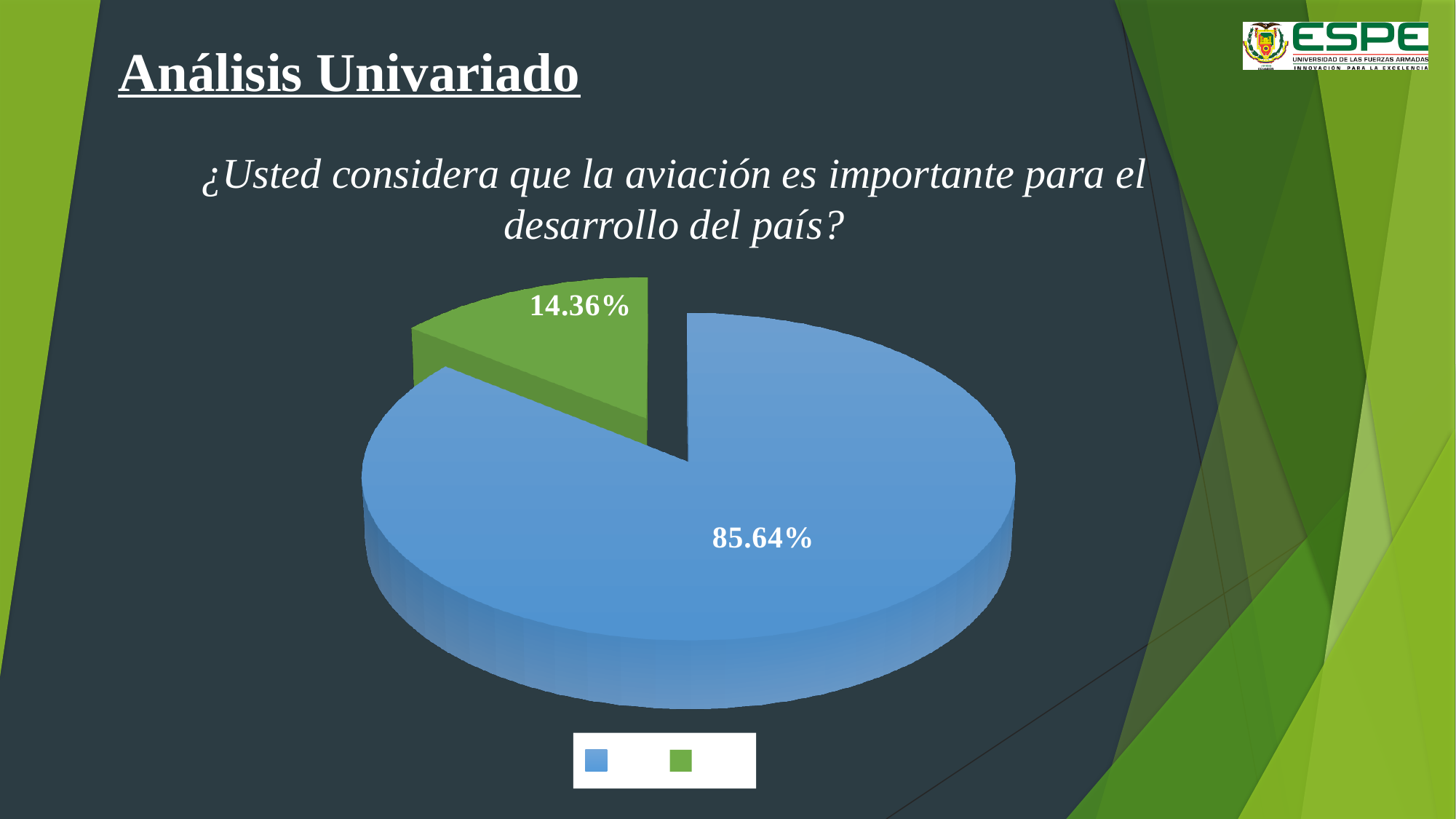
Which slice of the pie chart is the largest? the blue slice How many slices does the pie chart have? 2 What percentage is shown on the blue slice of the pie chart? 85.64% Which is larger, the blue slice or the green slice? the blue slice Which slice of the pie chart is the smallest? the green slice What kind of chart is shown on the slide? pie chart What is the difference in percentage points between the blue slice and the green slice? 71.28 Is the value of the blue slice greater or less than 80%? greater What do the two slice percentages add up to? 100% What percentage is shown on the green slice of the pie chart? 14.36% What survey question is shown above the pie chart? ¿Usted considera que la aviación es importante para el desarrollo del país? Is the value of the green slice greater or less than 20%? less